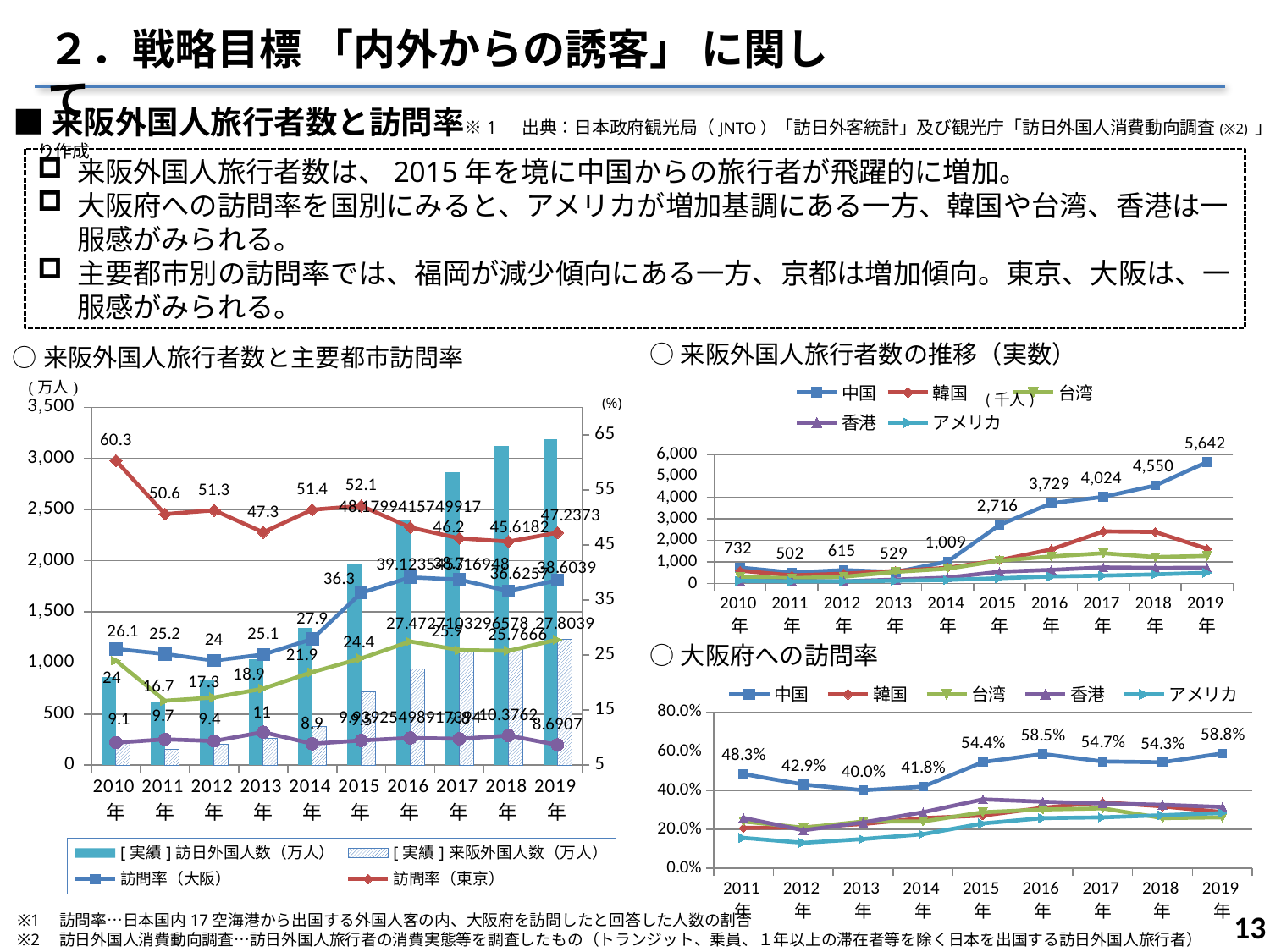
In the chart titled 来阪外国人旅行者数の推移（実数）, how many years are plotted on the x axis? 10 In the chart titled 大阪府への訪問率, is the value for アメリカ in 2012年 greater or less than 20.0%? less In the chart titled 来阪外国人旅行者数の推移（実数）, what is the value for 中国 in 2019年? 5,642 In the chart titled 大阪府への訪問率, what is the value for 中国 in 2019年? 58.8% In the chart titled 大阪府への訪問率, in which year is the 中国 value lowest? 2013年 In the chart titled 来阪外国人旅行者数の推移（実数）, what is the value for 中国 in 2015年? 2,716 How many series does the legend of the chart titled 来阪外国人旅行者数の推移（実数） list? 5 In the chart titled 来阪外国人旅行者数の推移（実数）, by how much did the 中国 value increase from 2018年 to 2019年? 1,092 In the chart titled 来阪外国人旅行者数と主要都市訪問率, which is larger in 2010年, 訪問率（東京） or 訪問率（大阪）? 訪問率（東京） In the chart titled 来阪外国人旅行者数と主要都市訪問率, what is the 訪問率（東京） value for 2010年? 60.3 In the chart titled 大阪府への訪問率, what is the difference between the 中国 values for 2016年 and 2015年? 4.1% What kind of chart is the one titled 来阪外国人旅行者数と主要都市訪問率? Combined bar and line chart